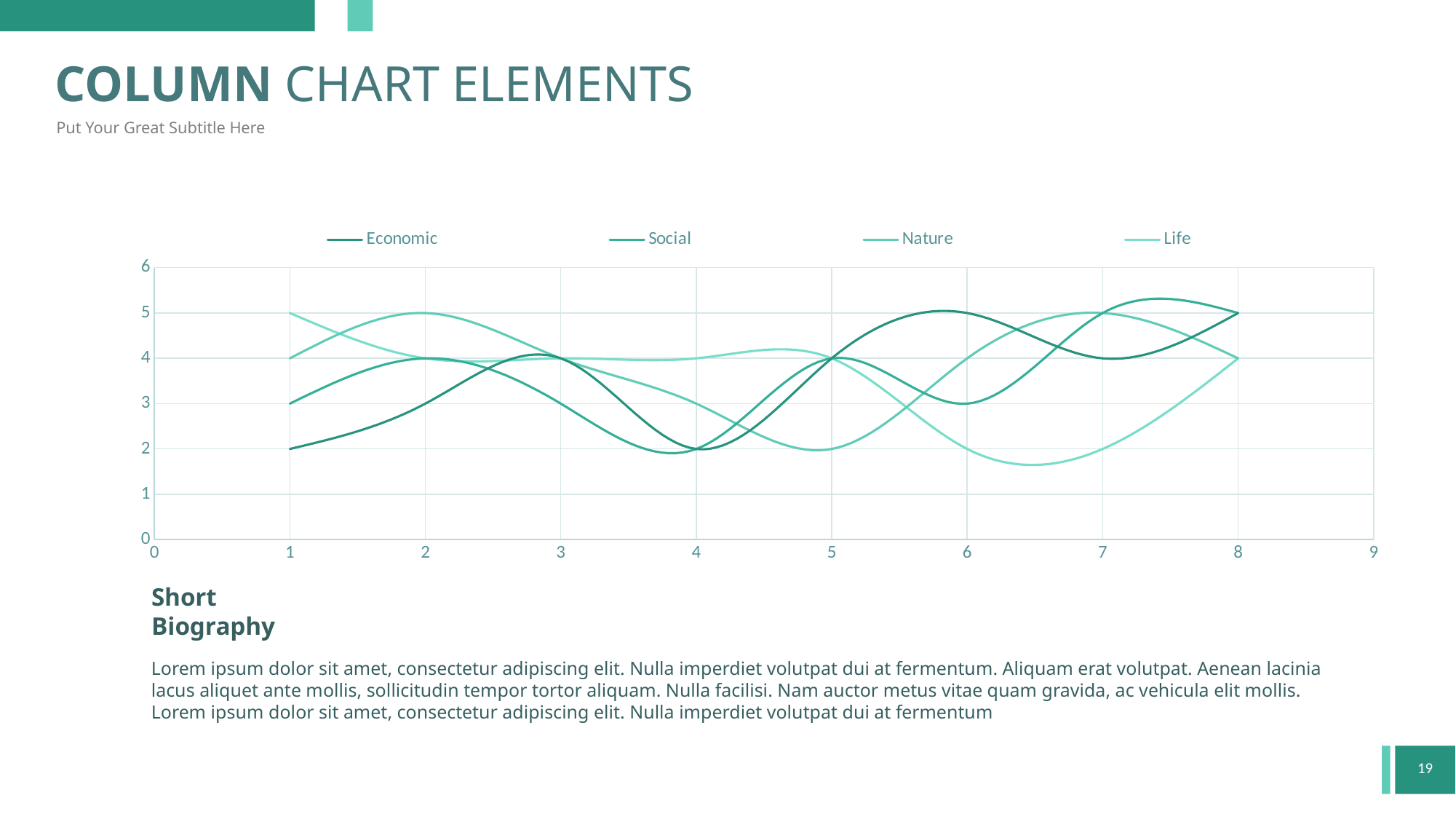
How many data points does each line have? 8 At x = 1, which series has the lowest value? Economic What is the difference between the Life and Economic values at x = 1? 3 At x = 7, which is larger: the Economic value or the Social value? Social What is the value of the Social series at x = 7? 5 What is the value of the Nature series at x = 5? 2 What kind of chart is shown on the slide? Line chart What is the value of the Economic series at x = 1? 2 Which series is listed first in the legend? Economic What is the value of the Life series at x = 1? 5 At x = 6, which series has the highest value? Economic How many series does the legend list? 4